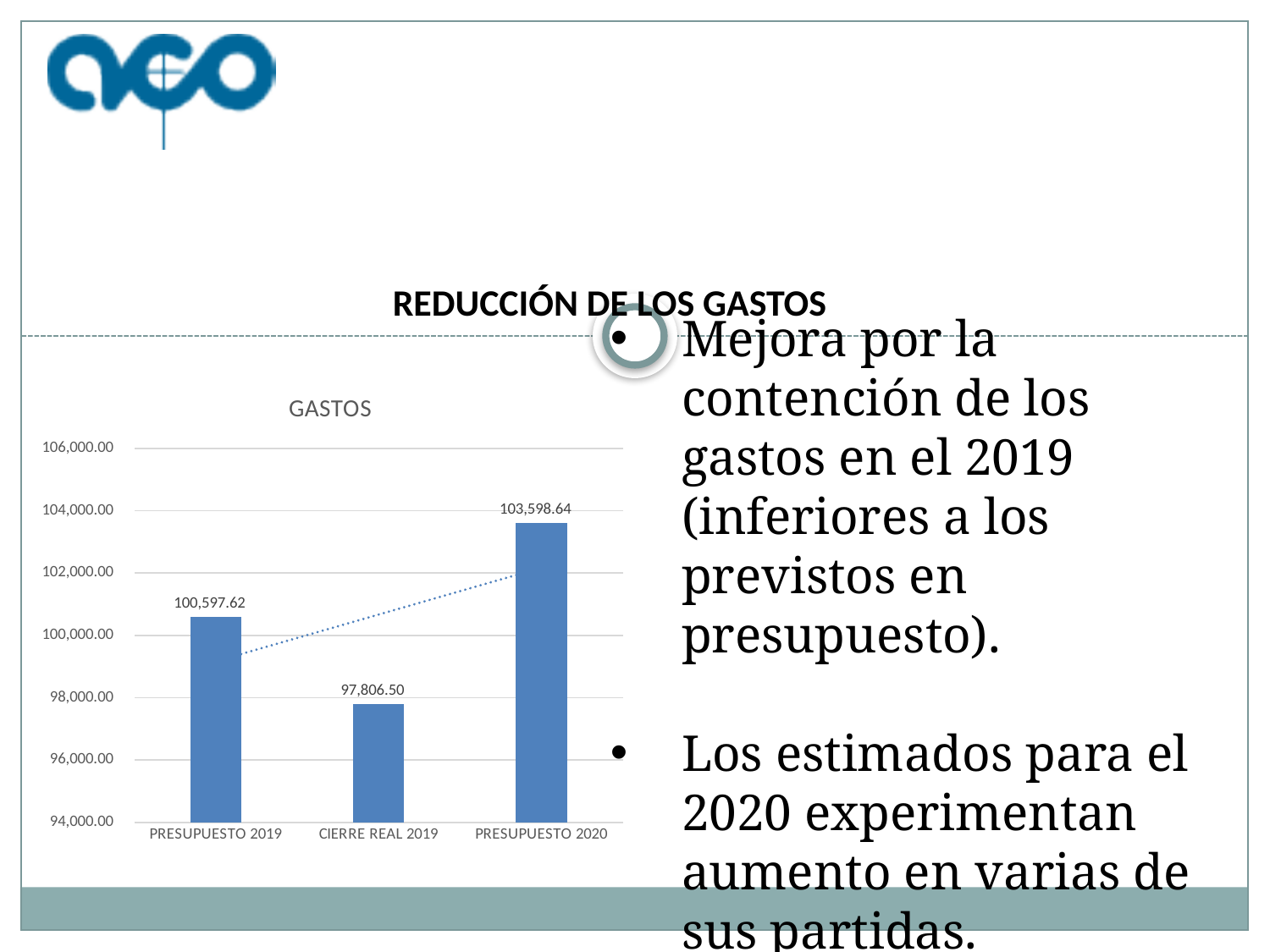
What is the value for PRESUPUESTO 2020 in the GASTOS chart? 103,598.64 Which is larger in the GASTOS chart, PRESUPUESTO 2019 or CIERRE REAL 2019? PRESUPUESTO 2019 What is the difference between PRESUPUESTO 2020 and PRESUPUESTO 2019 in the GASTOS chart? 3,001.02 Which category has the lowest value in the GASTOS chart? CIERRE REAL 2019 Is the value for CIERRE REAL 2019 greater or less than 98,000.00? less What is the difference between PRESUPUESTO 2019 and CIERRE REAL 2019 in the GASTOS chart? 2,791.12 What is the value for CIERRE REAL 2019 in the GASTOS chart? 97,806.50 What kind of chart is the GASTOS chart? bar chart What is the value for PRESUPUESTO 2019 in the GASTOS chart? 100,597.62 How many categories are shown in the GASTOS chart? 3 What is the title of the chart on the slide? GASTOS Which category has the highest value in the GASTOS chart? PRESUPUESTO 2020